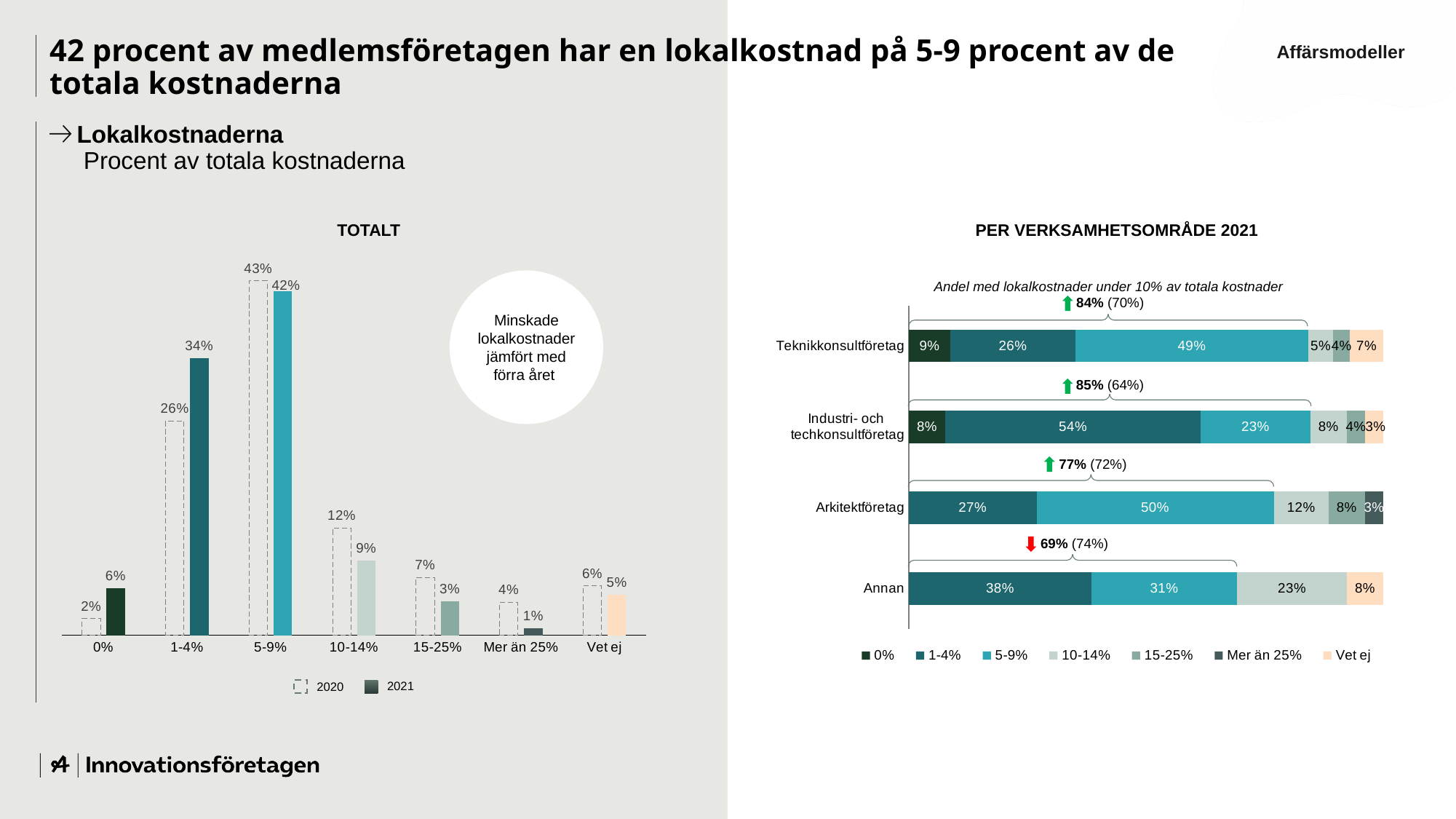
In the TOTALT chart, which category has the lowest 2021 value? Mer än 25% How many series does the legend of the PER VERKSAMHETSOMRÅDE 2021 chart list? 7 In the PER VERKSAMHETSOMRÅDE 2021 chart, how many categories (business areas) are shown? 4 How many series does the legend of the TOTALT chart list? 2 In the TOTALT chart, is the 2021 value for 1-4% larger or smaller than the 2020 value for 1-4%? larger In the TOTALT chart, which category has the highest 2021 value? 5-9% In the TOTALT chart, what is the 2020 value for the 1-4% category? 26% What kind of chart is the PER VERKSAMHETSOMRÅDE 2021 chart? Stacked bar chart In the PER VERKSAMHETSOMRÅDE 2021 chart, what is the 5-9% share for Teknikkonsultföretag? 49% In the TOTALT chart, what is the 2021 value for the 5-9% category? 42% In the TOTALT chart, what is the difference between the 2020 and 2021 values for the 10-14% category? 3% In the PER VERKSAMHETSOMRÅDE 2021 chart, what is the 1-4% share for Industri- och techkonsultföretag? 54%